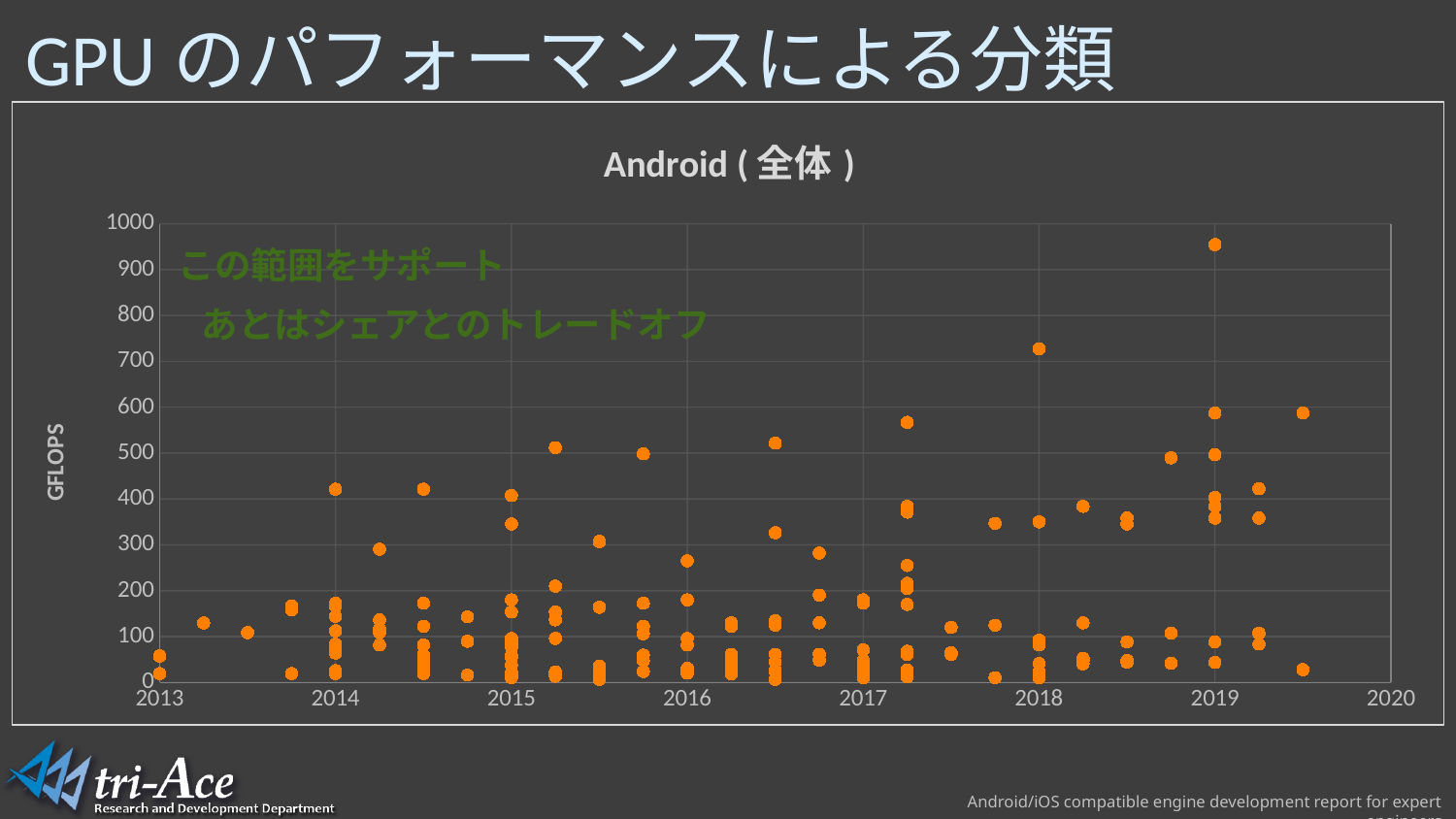
What is the maximum value shown on the vertical axis? 1000 What is the label on the vertical axis of the chart? GFLOPS What is the title of the chart? Android ( 全体 ) Is the highest point plotted at 2013 greater or less than 100 GFLOPS? less What is the first year shown on the horizontal axis? 2013 Do the highest GFLOPS values generally rise or fall from 2013 to 2019? rise What is the last year shown on the horizontal axis? 2020 Which is higher: the highest point at 2019 or the highest point at 2017? 2019 Is the highest point plotted at 2018 greater or less than 700 GFLOPS? greater Around which year does the highest point on the chart appear? 2019 What kind of chart is shown on the slide? Scatter chart Is the highest point on the chart greater or less than 900 GFLOPS? greater